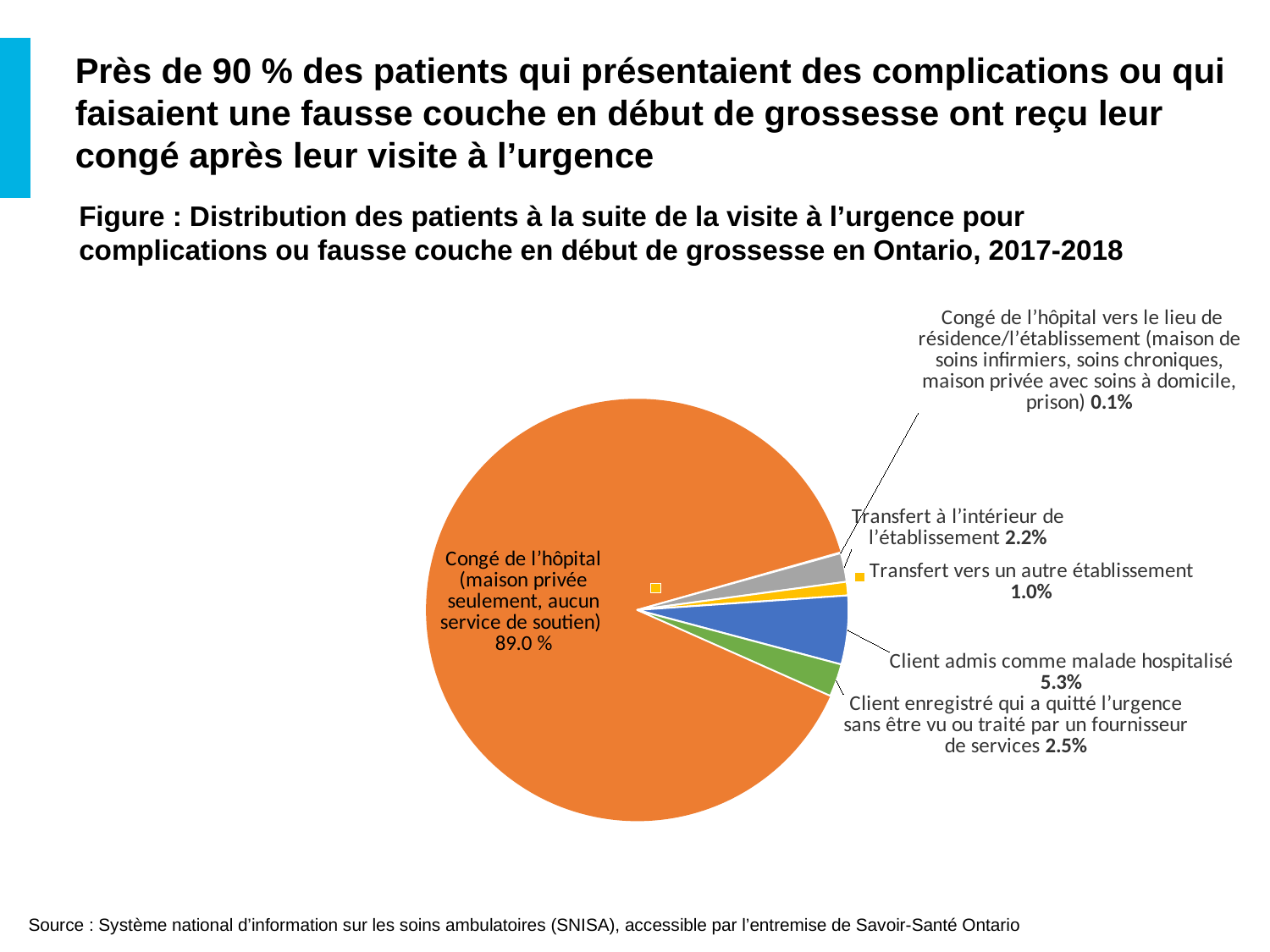
What type of chart is shown on the slide? Pie chart Which category has the smallest share of the pie? Congé de l'hôpital vers le lieu de résidence/l'établissement (maison de soins infirmiers, soins chroniques, maison privée avec soins à domicile, prison) What colour is the largest slice of the pie chart? Orange What percentage is shown for "Transfert à l'intérieur de l'établissement"? 2.2% What is the difference in percentage points between "Client admis comme malade hospitalisé" and "Client enregistré qui a quitté l'urgence sans être vu ou traité par un fournisseur de services"? 2.8 What percentage is shown for "Client admis comme malade hospitalisé"? 5.3% Which is larger: the share for "Client enregistré qui a quitté l'urgence sans être vu ou traité par un fournisseur de services" or for "Transfert à l'intérieur de l'établissement"? Client enregistré qui a quitté l'urgence sans être vu ou traité par un fournisseur de services What percentage is shown for "Transfert vers un autre établissement"? 1.0% What share of patients is shown for "Congé de l'hôpital (maison privée seulement, aucun service de soutien)"? 89.0 % How many slices does the pie chart have? 6 What percentage is shown for "Client enregistré qui a quitté l'urgence sans être vu ou traité par un fournisseur de services"? 2.5% Which category has the largest share of the pie? Congé de l'hôpital (maison privée seulement, aucun service de soutien)